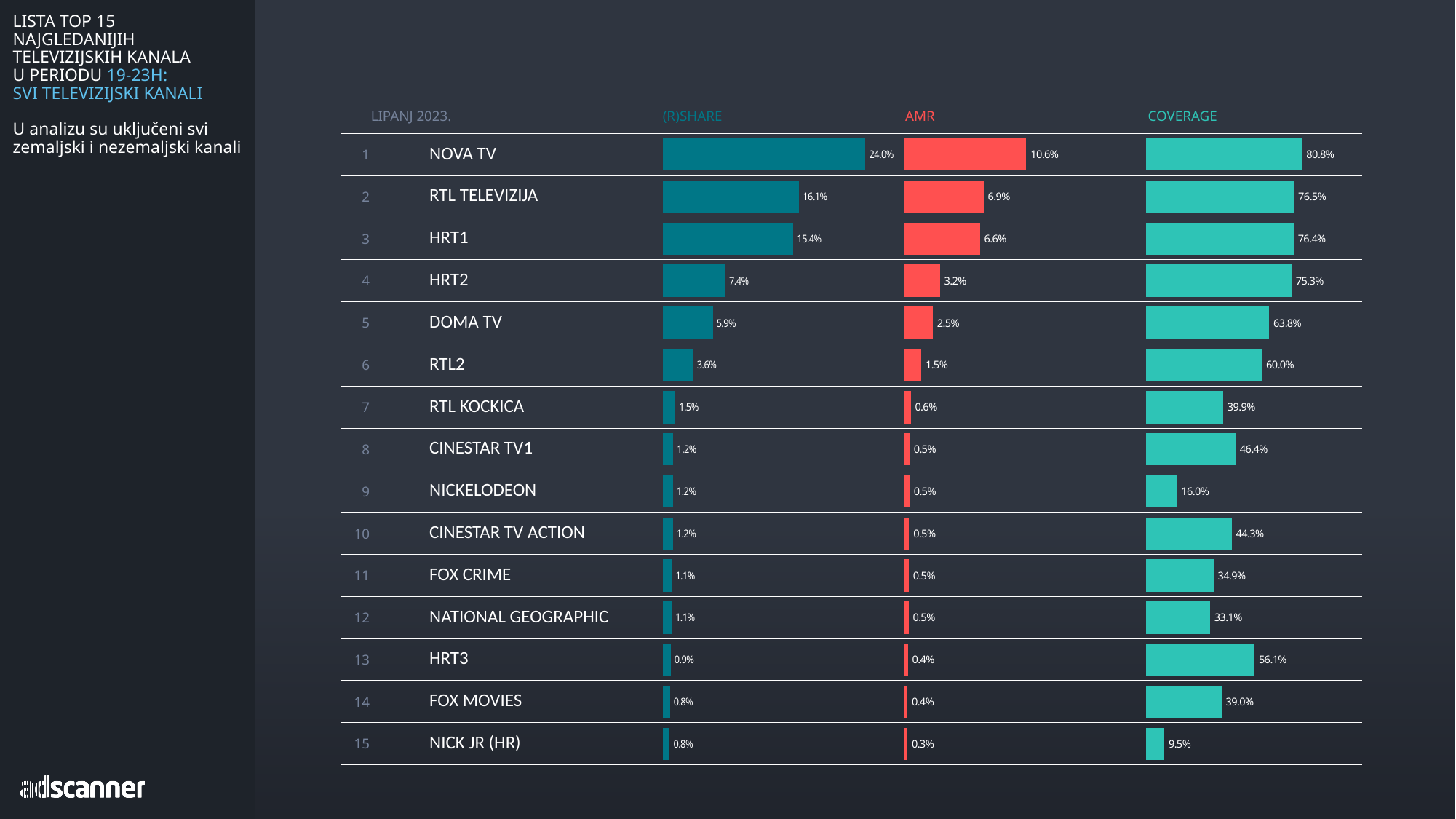
In the COVERAGE chart, which is larger: CINESTAR TV1 or NICKELODEON? CINESTAR TV1 In the COVERAGE chart, what is the difference between NOVA TV and DOMA TV? 17.0% In the COVERAGE chart, what is the value for HRT3? 56.1% In the AMR chart, which channel has the highest value? NOVA TV In the (R)SHARE chart, what is the difference between RTL TELEVIZIJA and HRT1? 0.7% In the AMR chart, which is larger: RTL2 or DOMA TV? DOMA TV How many channels are listed in the charts? 15 What kind of chart is used to show the (R)SHARE values? Bar chart What month and year is shown in the header of the table? LIPANJ 2023. In the (R)SHARE chart, what is the value for NOVA TV? 24.0% In the COVERAGE chart, which channel has the lowest value? NICK JR (HR) In the AMR chart, what is the value for HRT2? 3.2%